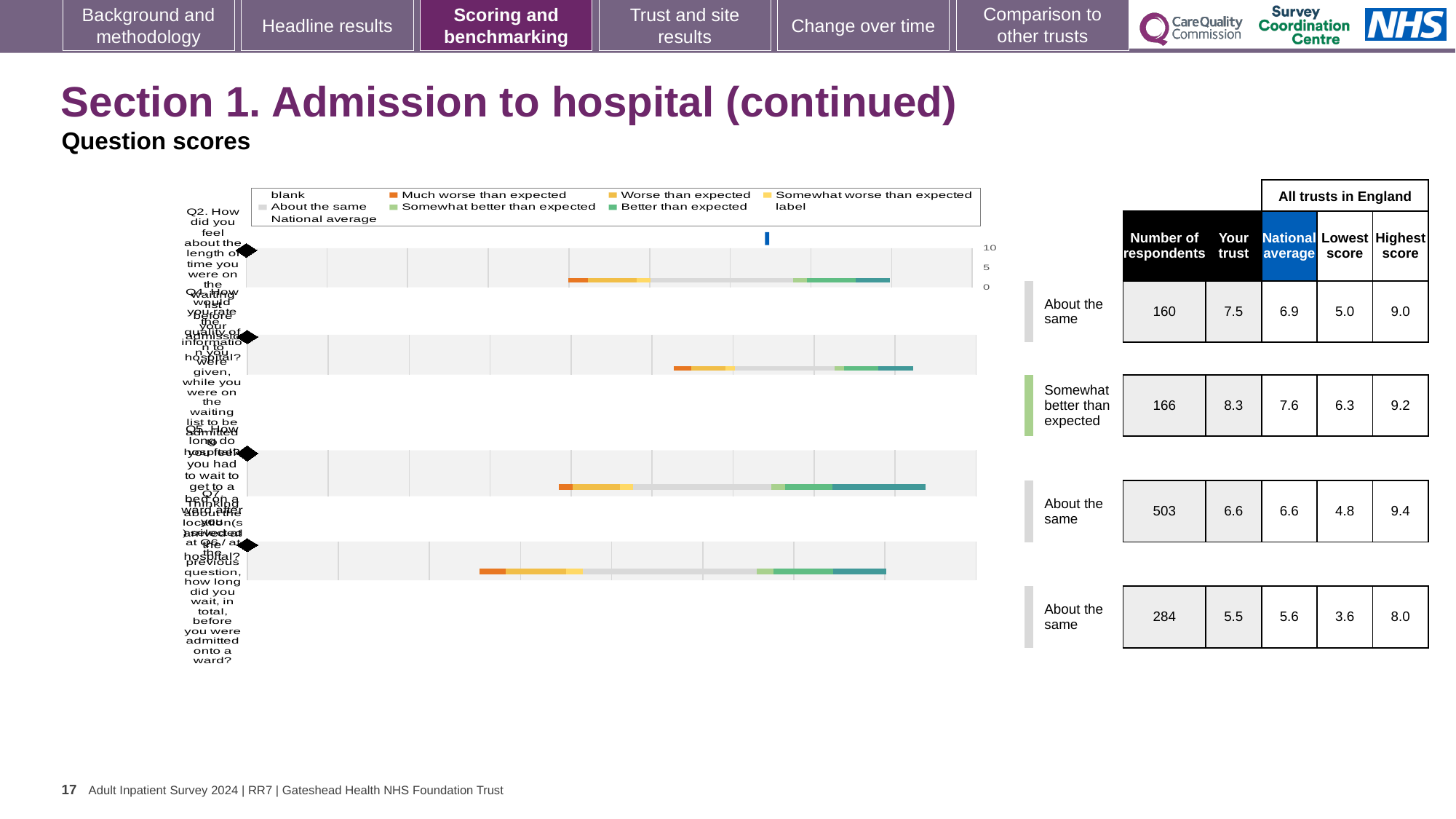
In the table, which row has the highest number of respondents? the third row (503) What is the highest value shown on the chart's axis scale? 10 In the table, what is the number of respondents for the first row (rated 'About the same')? 160 How many question bars are plotted in the chart? 4 In the table, is the 'Your trust' score for the row with 284 respondents larger or smaller than its national average? smaller What kind of chart is shown on the slide? bar chart In the table, what is the difference between 'Your trust' and 'National average' for the row with 166 respondents? 0.7 How many entries does the chart legend list? 9 In the table, what is the 'Your trust' score for the row rated 'Somewhat better than expected'? 8.3 In the table, what is the lowest score for the last row (284 respondents)? 3.6 Which legend entry is shown in dark orange? Much worse than expected How many of the four questions are rated 'About the same'? 3